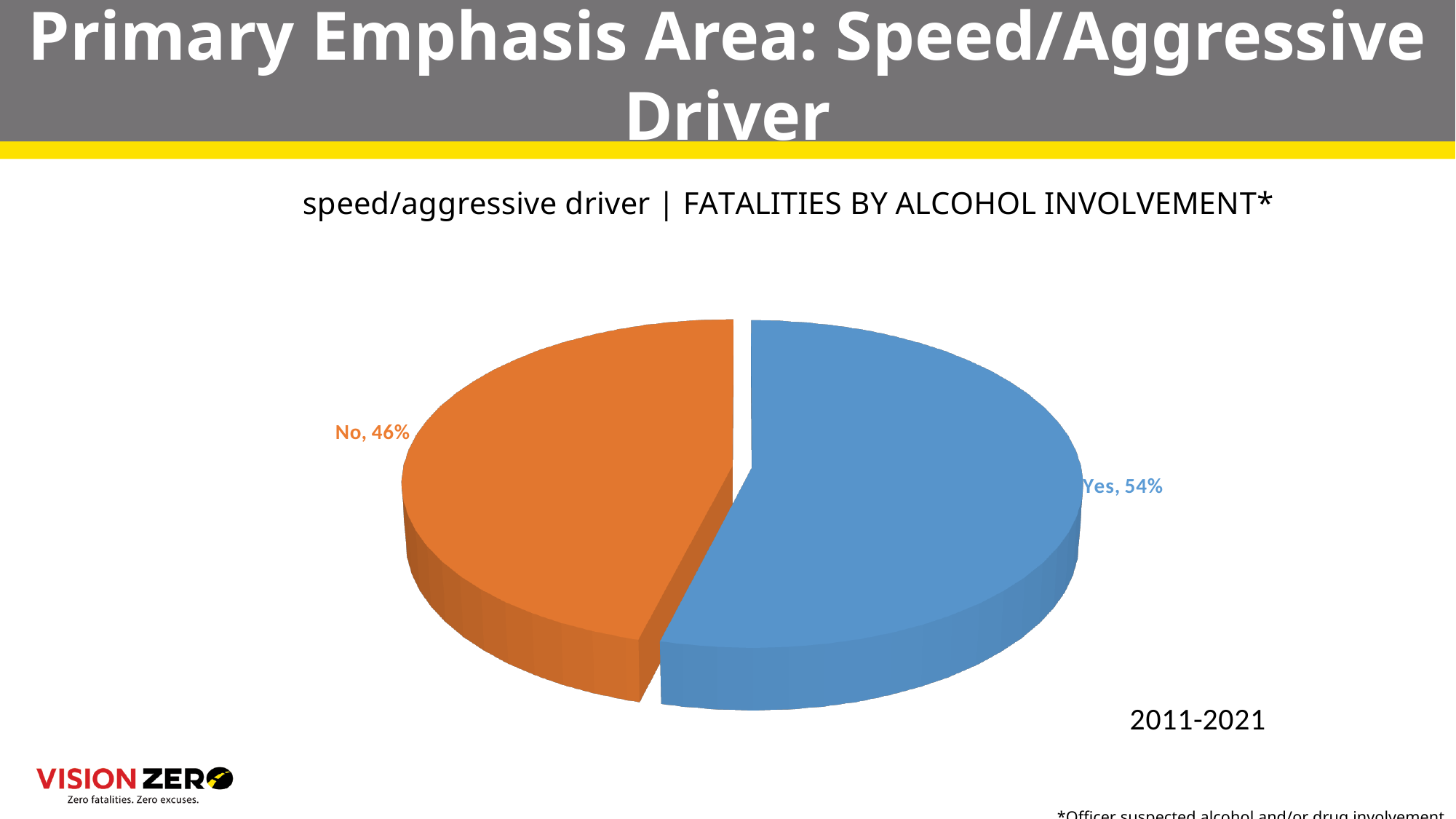
What colour is the Yes slice of the pie? blue What is the title of the chart? speed/aggressive driver | FATALITIES BY ALCOHOL INVOLVEMENT* Which category has the smallest share of the pie? No Is the share for No greater or less than 50%? less What share of speed/aggressive driver fatalities did not involve alcohol (No)? 46% Which slice of the pie is larger, Yes or No? Yes How many slices does the pie chart have? 2 What year range does the chart cover? 2011-2021 What is the difference in percentage points between the Yes and No slices? 8 Which category has the largest share of the pie? Yes What type of chart is shown on the slide? pie chart What share of speed/aggressive driver fatalities involved alcohol (Yes)? 54%